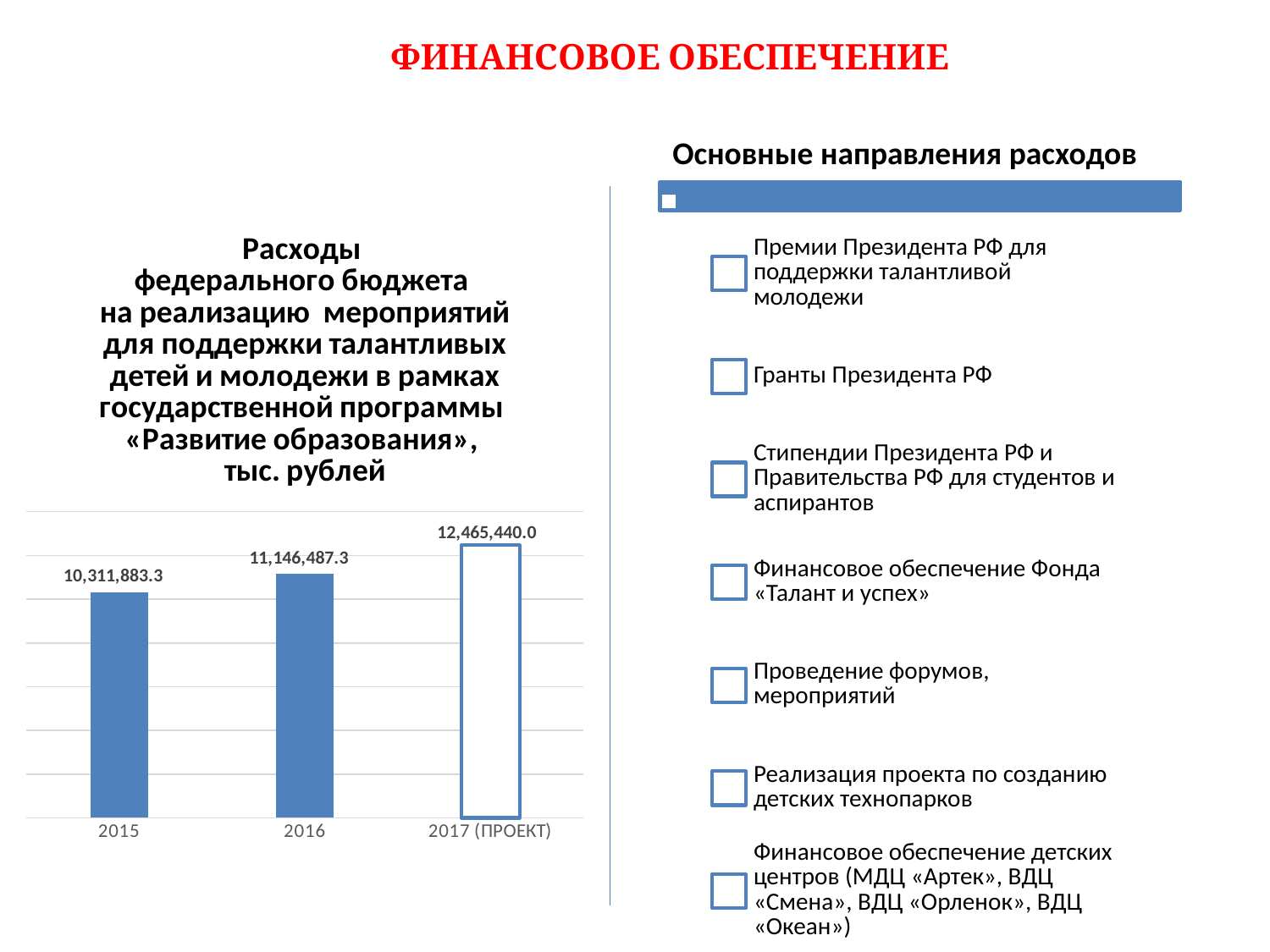
What is the value shown for 2017 (ПРОЕКТ)? 12,465,440.0 In what units are the chart values expressed, according to the chart title? тыс. рублей Which year has the lowest value in the chart? 2015 What is the value shown for 2015? 10,311,883.3 What is the value shown for 2016? 11,146,487.3 What kind of chart is shown on the slide? Bar chart Which year has the highest value in the chart? 2017 (ПРОЕКТ) Which is larger, the value for 2015 or the value for 2016? 2016 What is the difference between the values for 2016 and 2015? 834,604.0 What is the difference between the values for 2017 (ПРОЕКТ) and 2016? 1,318,952.7 Do the values rise or fall from 2015 to 2017 (ПРОЕКТ)? Rise How many categories (years) are plotted in the chart? 3